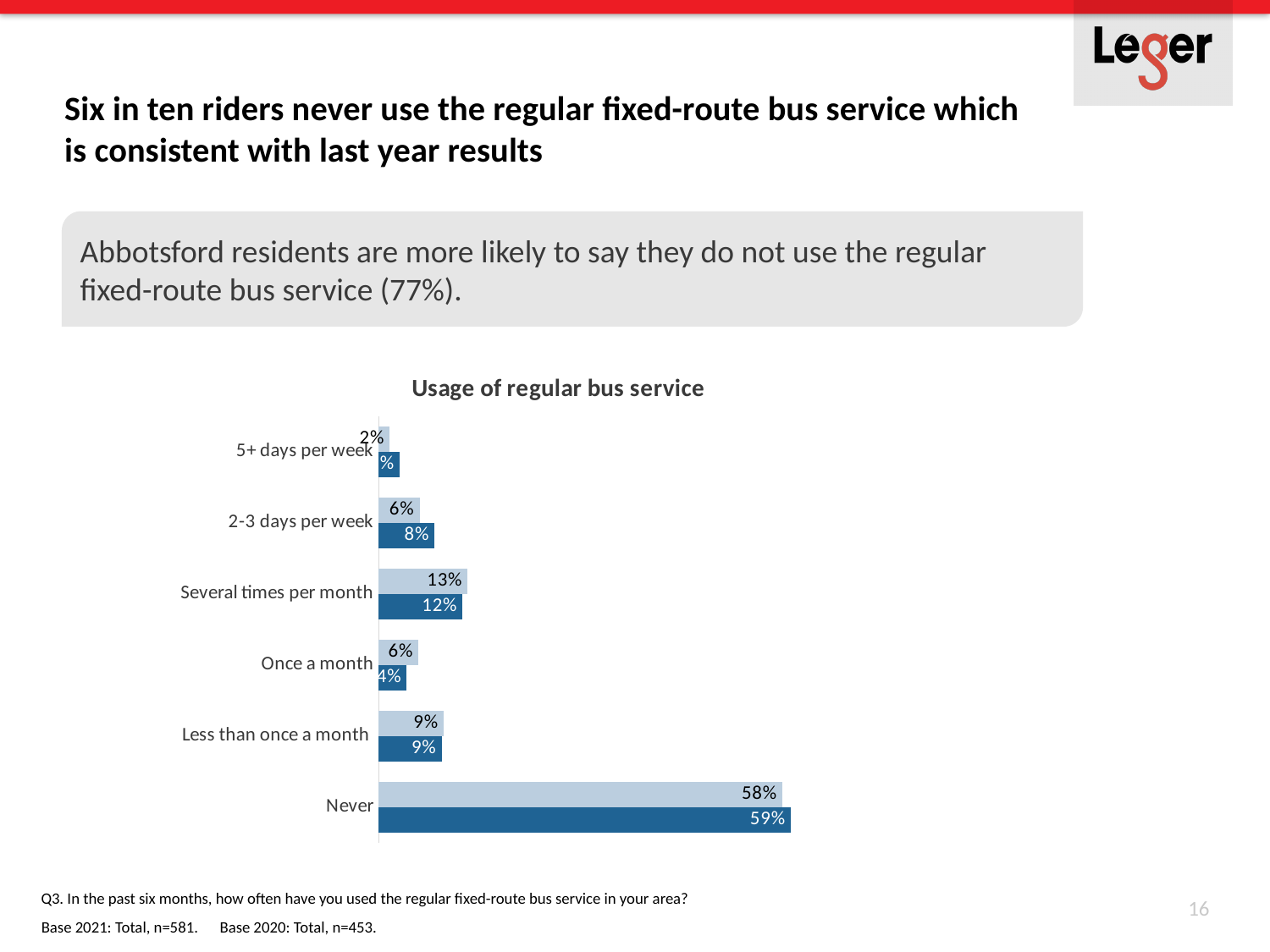
What is the value of the dark blue bar for 'Once a month'? 4% What is the value of the light blue bar for 'Several times per month'? 13% What is the difference between the light blue and dark blue bars for 'Several times per month'? 1% How many usage categories are shown in the chart? 6 What is the value of the dark blue bar for 'Never'? 59% Which category has the highest values in the chart? Never What is the value of the light blue bar for 'Never'? 58% For 'Once a month', which bar is larger, the light blue or the dark blue? light blue What type of chart is shown on the slide? bar chart What is the value of the dark blue bar for '2-3 days per week'? 8% Which category has the lowest light blue bar value? 5+ days per week What is the title of the chart? Usage of regular bus service